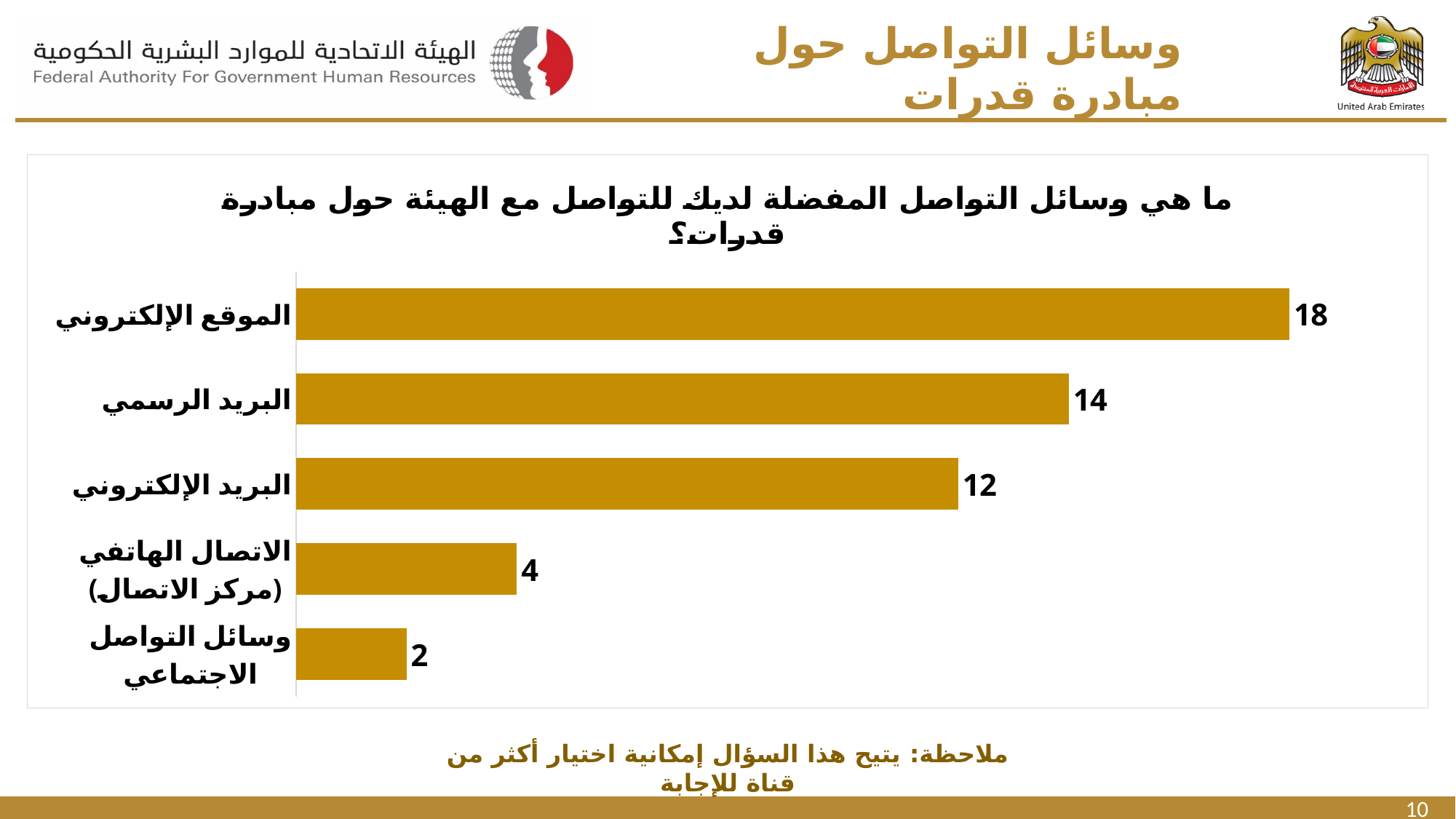
What is the value for الموقع الإلكتروني? 18 What is the title of the chart? ما هي وسائل التواصل المفضلة لديك للتواصل مع الهيئة حول مبادرة قدرات؟ Which is larger, the value for البريد الإلكتروني or the value for الاتصال الهاتفي (مركز الاتصال)? البريد الإلكتروني What is the value for البريد الإلكتروني? 12 What is the difference between the values for الموقع الإلكتروني and البريد الرسمي? 4 What is the value for البريد الرسمي? 14 How many categories are shown in the chart? 5 What is the value for الاتصال الهاتفي (مركز الاتصال)? 4 What kind of chart is shown on the slide? bar chart Which category has the lowest value? وسائل التواصل الاجتماعي Which category has the highest value? الموقع الإلكتروني What is the value for وسائل التواصل الاجتماعي? 2